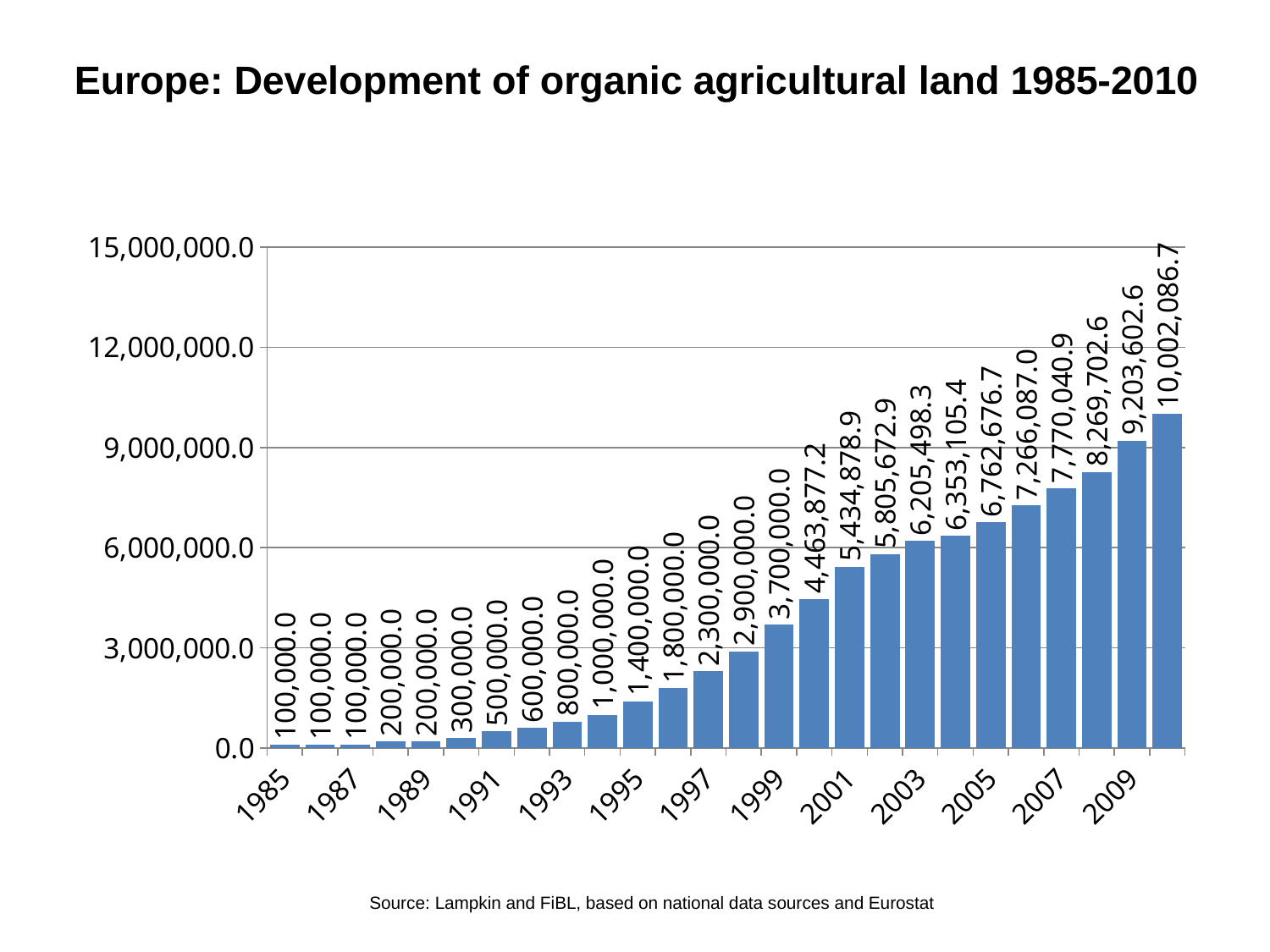
How many bars are plotted in the chart? 26 What is the value for 1999? 3,700,000.0 What type of chart is shown on the slide? bar chart Which year has the lowest value among the labelled years 1985, 1987 and 1989? 1985 and 1987 are tied at 100,000.0 What is the value for 1995? 1,400,000.0 What is the value for 2005? 6,762,676.7 Do the values generally rise or fall from 1985 to 2010? rise Which is larger, the value for 2001 or the value for 1997? 2001 What is the difference between the values for 2007 and 2003? 1,564,542.6 What is the value for 2009? 9,203,602.6 What is the value of the tallest bar in the chart? 10,002,086.7 Is the value for 2009 greater or less than 9,000,000.0? greater